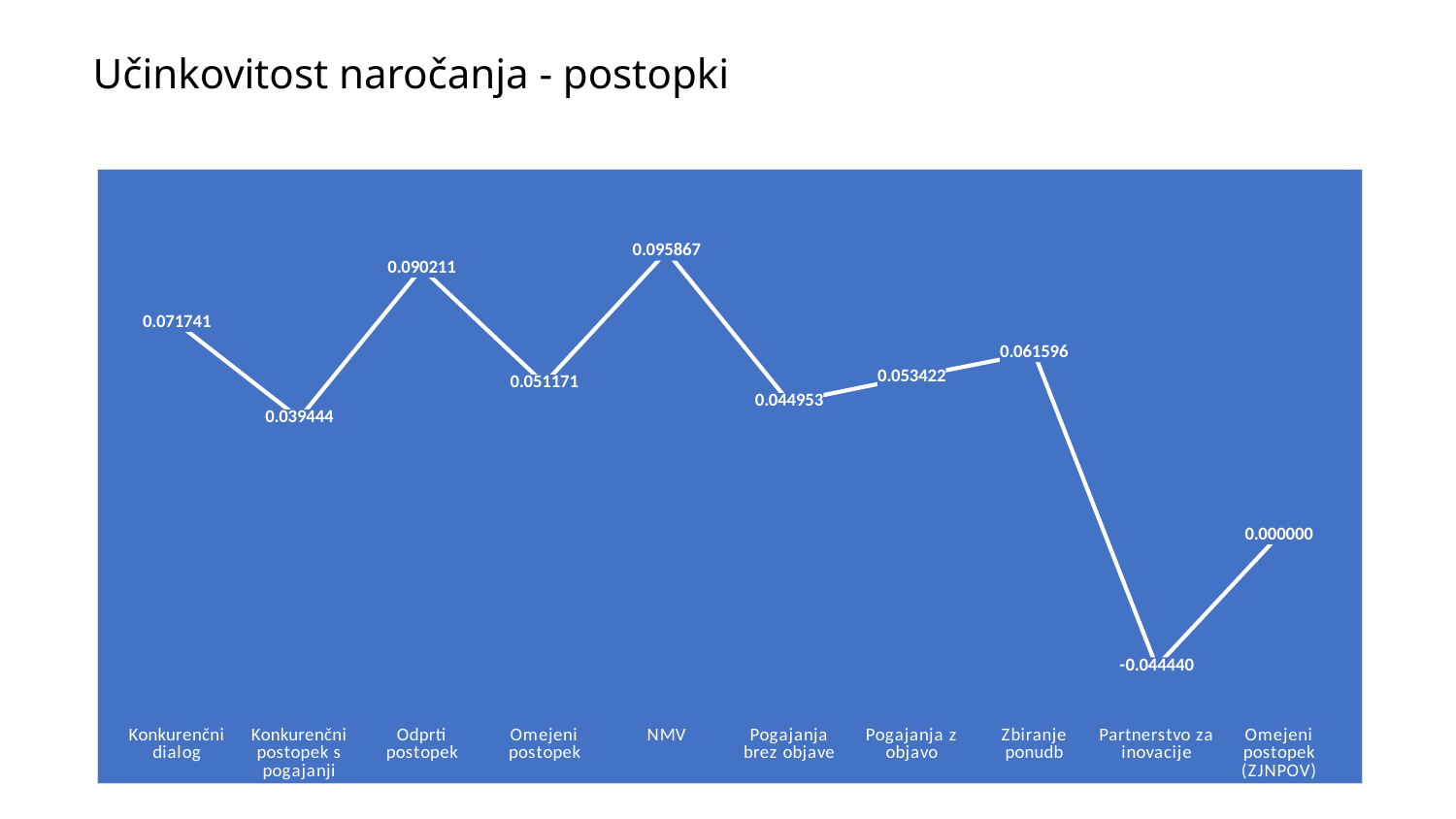
What is the difference between the values for Odprti postopek and Omejeni postopek? 0.039040 What is the difference between the values for Zbiranje ponudb and Pogajanja z objavo? 0.008174 How many categories are plotted on the x axis? 10 What type of chart is shown on the slide? Line chart Which category has the lowest value? Partnerstvo za inovacije What is the title of the slide? Učinkovitost naročanja - postopki Which category has the highest value? NMV What is the value for Odprti postopek? 0.090211 What is the value for NMV? 0.095867 What is the value for Partnerstvo za inovacije? -0.044440 What is the value for Omejeni postopek (ZJNPOV)? 0.000000 Which is larger, the value for Konkurenčni dialog or the value for Konkurenčni postopek s pogajanji? Konkurenčni dialog